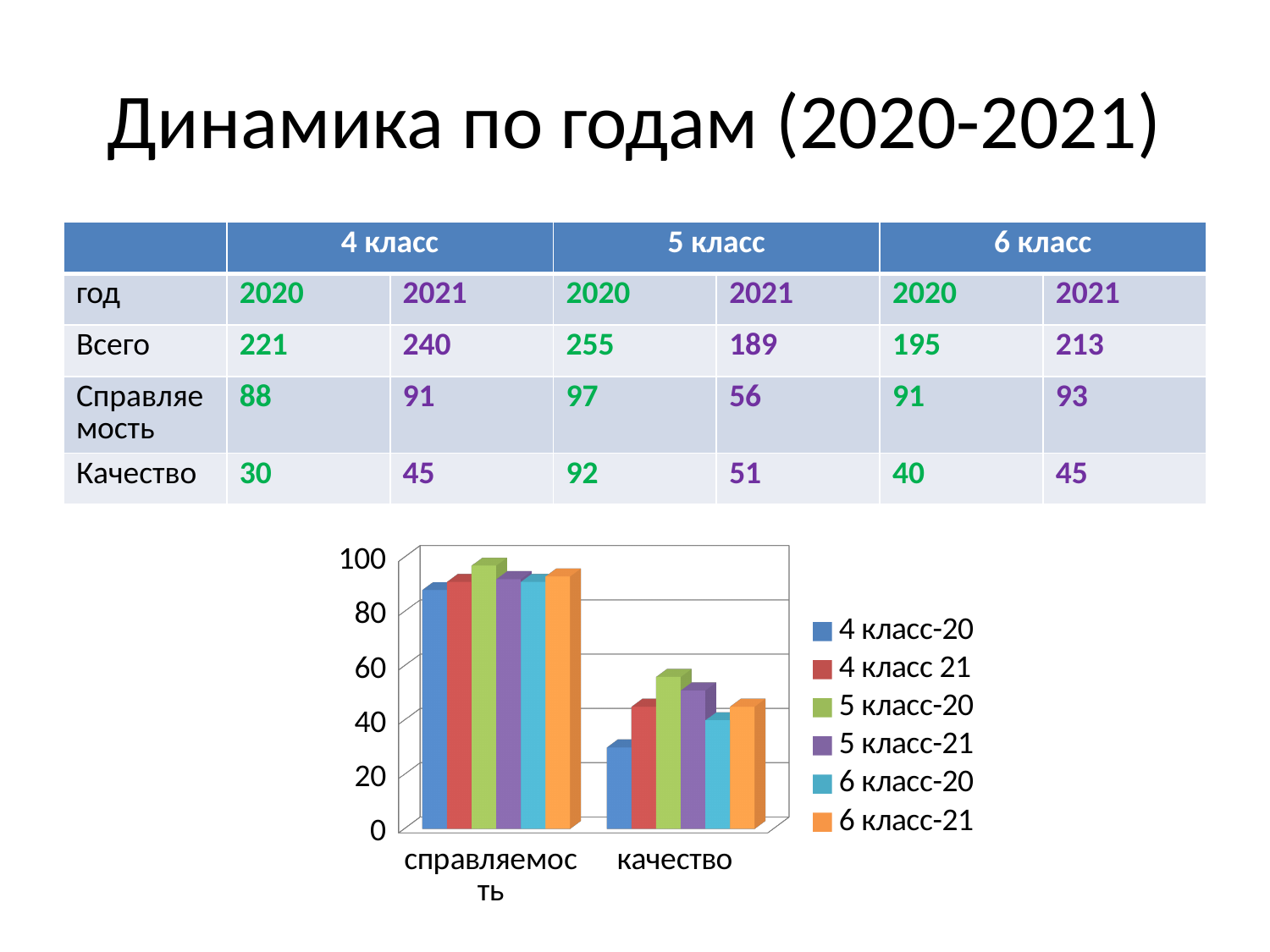
What kind of chart is shown on the slide? bar chart Is the value for 4 класс-20 in the качество category greater or less than 40? less In the справляемость category, which series has the highest bar? 5 класс-20 Is the value for 5 класс-20 in the справляемость category greater or less than 80? greater In the качество category, which is larger: the bar for 4 класс-20 or the bar for 4 класс 21? 4 класс 21 What is the first category label on the x axis of the chart? справляемость Which series is shown in orange in the chart legend? 6 класс-21 In the качество category, which series has the lowest bar? 4 класс-20 How many series does the chart legend list? 6 How many categories are shown on the x axis of the chart? 2 For the 6 класс-21 series, which category has the larger bar: справляемость or качество? справляемость Is the value for 6 класс-20 in the качество category greater or less than 60? less